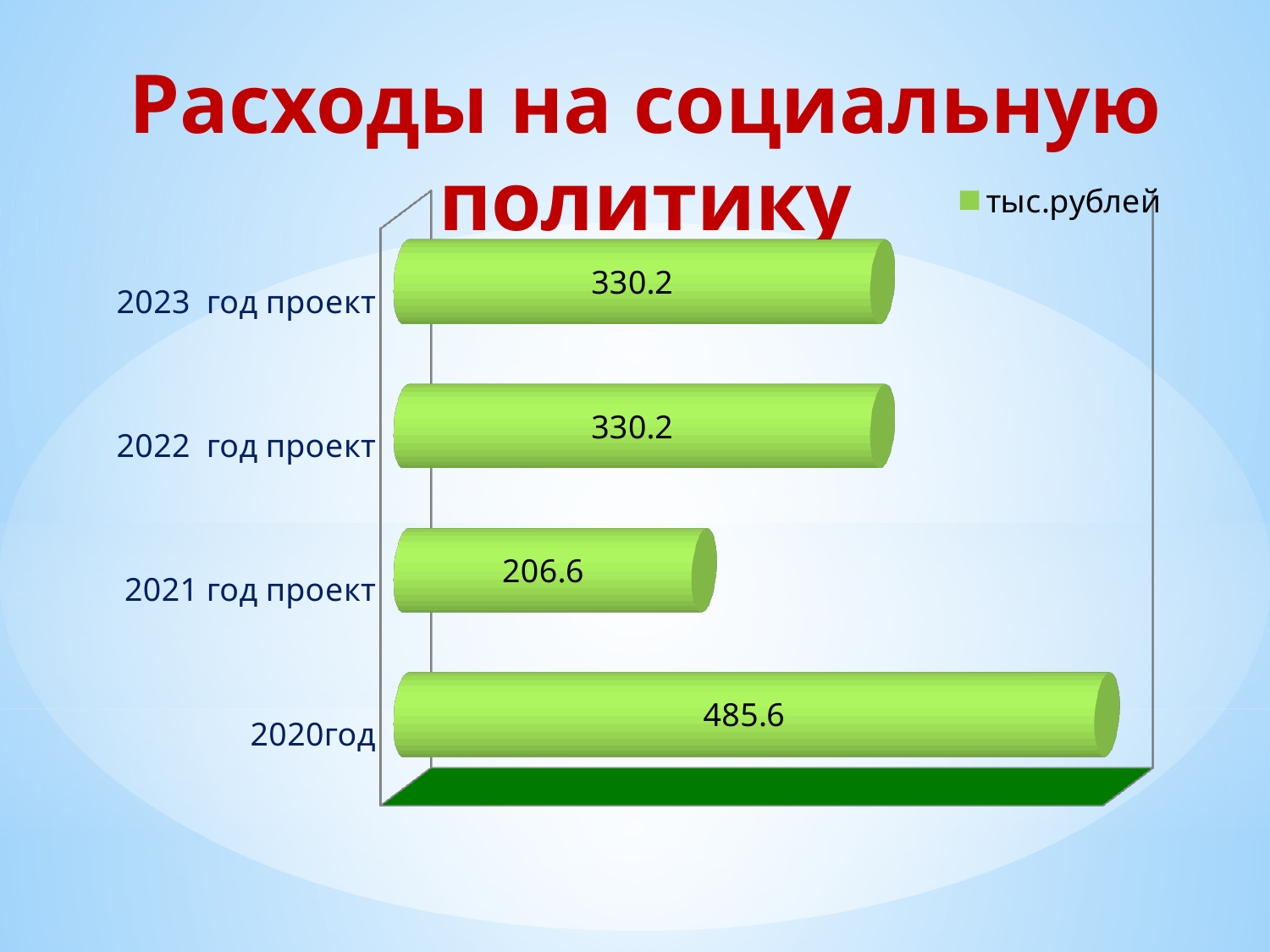
What is the difference between the values for 2020год and 2021 год проект? 279.0 What kind of chart is shown on the slide? Bar chart What is the value for 2021 год проект? 206.6 Which is larger, the value for 2022 год проект or the value for 2021 год проект? 2022 год проект How many categories are shown in the chart? 4 What is the difference between the values for 2020год and 2023 год проект? 155.4 Which category has the highest value? 2020год How many series does the legend list? 1 What is the value for 2023 год проект? 330.2 What is the value for 2022 год проект? 330.2 What is the value for 2020год? 485.6 Which category has the lowest value? 2021 год проект